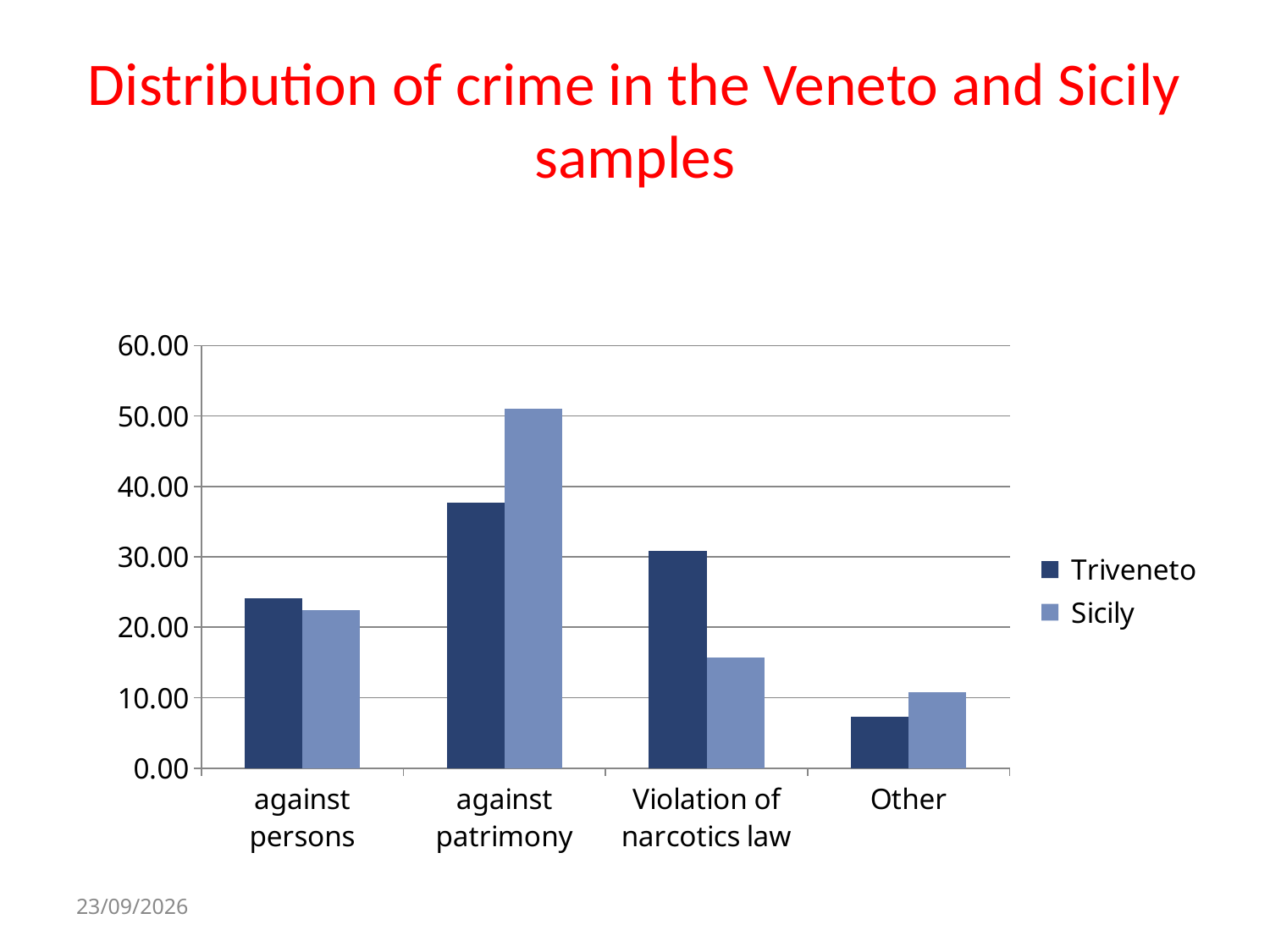
For against patrimony, which series has the larger value, Triveneto or Sicily? Sicily Is the Sicily value for against patrimony greater or less than 40.00? greater Which category has the highest value for Triveneto? against patrimony Is the Sicily value for Violation of narcotics law greater or less than 20.00? less What kind of chart is shown on the slide? bar chart How many crime categories are shown on the x axis? 4 Which category has the highest value for Sicily? against patrimony Which category has the lowest value for Sicily? Other For Violation of narcotics law, which series has the larger value, Triveneto or Sicily? Triveneto Which category has the lowest value for Triveneto? Other How many series does the legend list? 2 What is the title of the slide containing the chart? Distribution of crime in the Veneto and Sicily samples